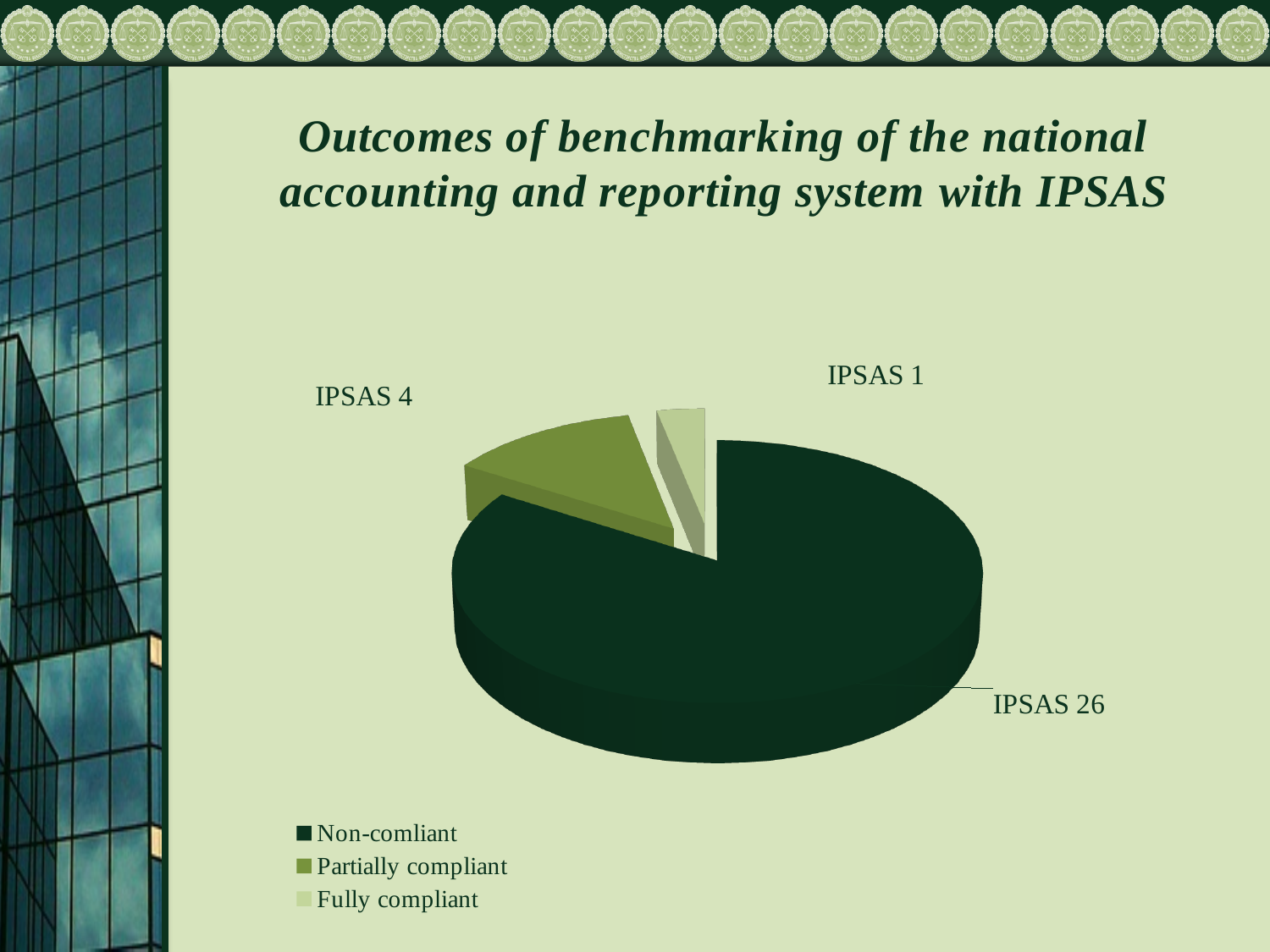
How many more IPSAS standards are non-compliant than partially compliant? 22 How many IPSAS standards are shown as partially compliant in the pie chart? 4 What is the data label on the Non-compliant slice of the pie chart? IPSAS 26 How many IPSAS standards are shown as fully compliant in the pie chart? 1 How many slices does the pie chart have? 3 What kind of chart is shown on the slide? pie chart How many entries does the legend of the pie chart list? 3 Which category has the smallest slice in the pie chart? Fully compliant Which slice is larger: Partially compliant or Fully compliant? Partially compliant What is the total number of IPSAS standards across all three slices of the pie chart? 31 What is the title of the slide containing the pie chart? Outcomes of benchmarking of the national accounting and reporting system with IPSAS Which category has the largest slice in the pie chart? Non-compliant